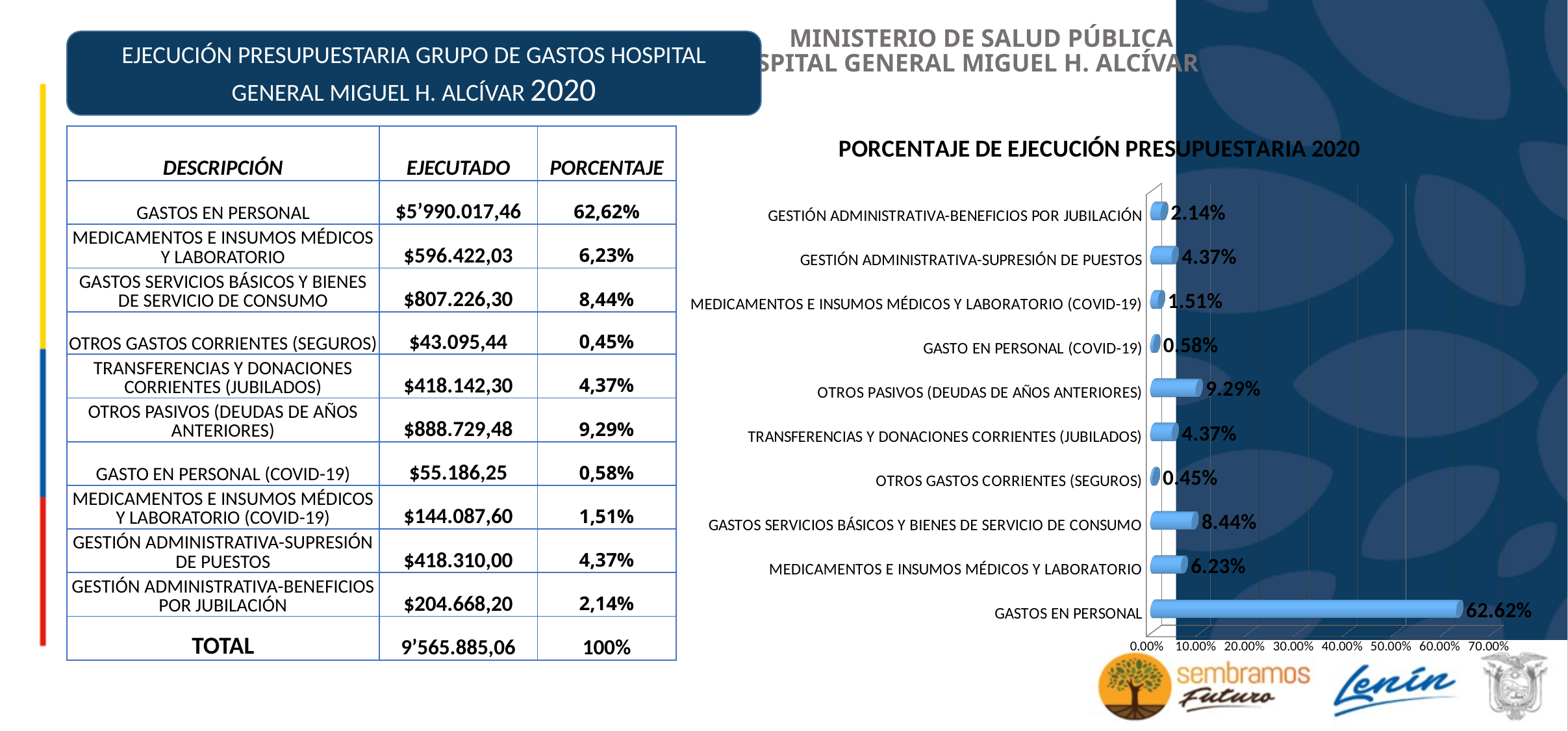
In the chart, what is the value for GESTIÓN ADMINISTRATIVA-BENEFICIOS POR JUBILACIÓN? 2.14% In the chart, what is the difference between the values for GASTOS EN PERSONAL and OTROS PASIVOS (DEUDAS DE AÑOS ANTERIORES)? 53.33% How many categories are plotted in the chart? 10 Is the value for GASTOS EN PERSONAL in the chart greater or less than 60.00%? greater In the chart, which is larger: GASTOS SERVICIOS BÁSICOS Y BIENES DE SERVICIO DE CONSUMO or MEDICAMENTOS E INSUMOS MÉDICOS Y LABORATORIO? GASTOS SERVICIOS BÁSICOS Y BIENES DE SERVICIO DE CONSUMO In the chart, what is the value for GASTOS EN PERSONAL? 62.62% Which category has the highest value in the chart? GASTOS EN PERSONAL What is the title of the chart on the right side of the slide? PORCENTAJE DE EJECUCIÓN PRESUPUESTARIA 2020 What type of chart is shown under the title "PORCENTAJE DE EJECUCIÓN PRESUPUESTARIA 2020"? bar chart Which category has the lowest value in the chart? OTROS GASTOS CORRIENTES (SEGUROS) In the chart, what is the value for MEDICAMENTOS E INSUMOS MÉDICOS Y LABORATORIO (COVID-19)? 1.51% In the chart, what is the value for OTROS PASIVOS (DEUDAS DE AÑOS ANTERIORES)? 9.29%